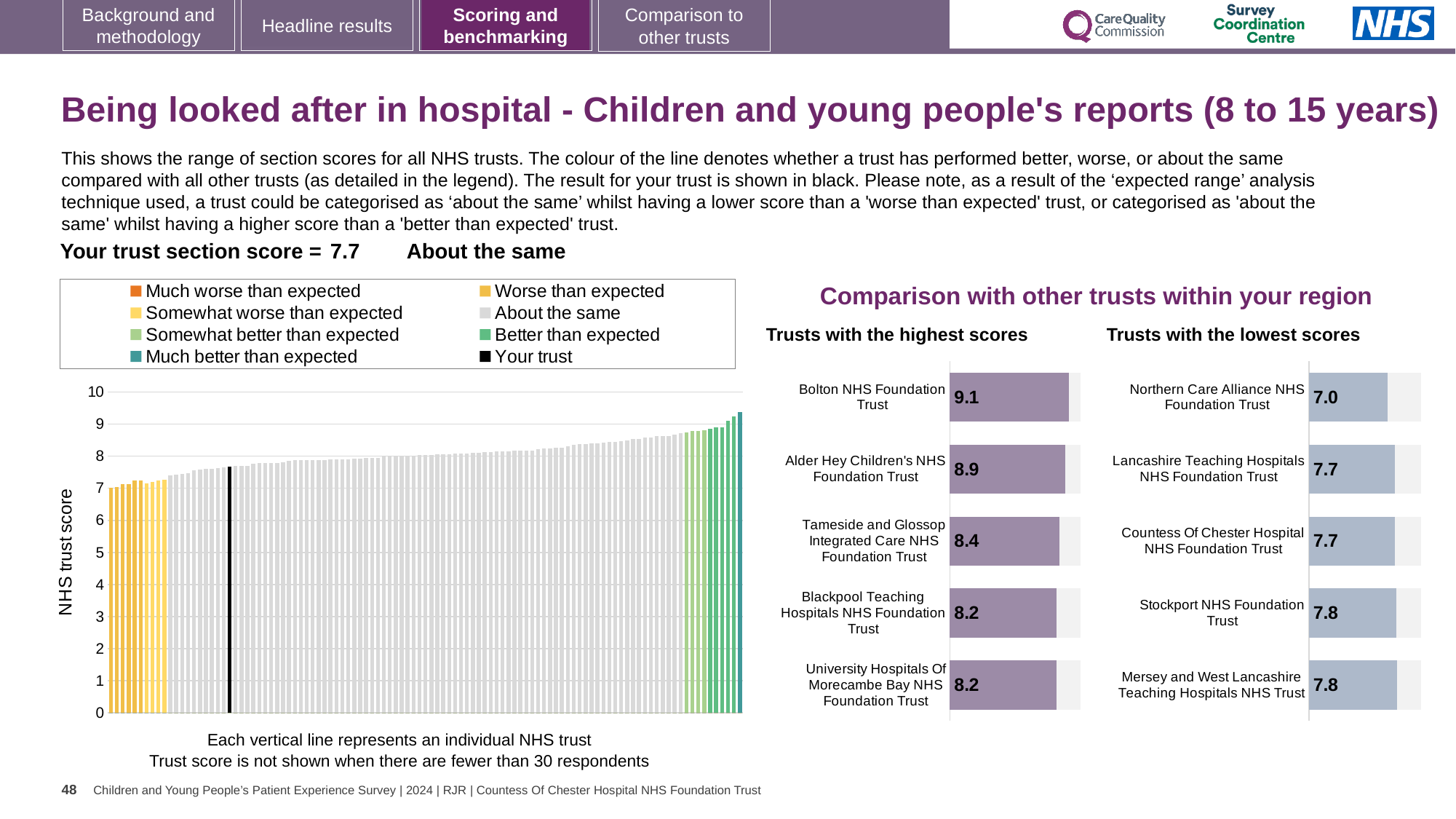
In the large chart on the left, is the value for the black 'Your trust' bar greater or less than 7? greater What kind of chart is the large chart on the left showing NHS trust scores? bar chart How many entries does the legend above the large chart on the left list? 8 In the 'Trusts with the highest scores' chart, which trust has the highest score? Bolton NHS Foundation Trust In the 'Trusts with the lowest scores' chart, what is the value for Northern Care Alliance NHS Foundation Trust? 7.0 In the 'Trusts with the lowest scores' chart, which is larger: the value for Stockport NHS Foundation Trust or Northern Care Alliance NHS Foundation Trust? Stockport NHS Foundation Trust How many trusts are shown in the 'Trusts with the highest scores' chart? 5 In the 'Trusts with the lowest scores' chart, which trust has the lowest score? Northern Care Alliance NHS Foundation Trust In the large chart on the left, do the trust scores rise or fall from left to right? rise In the 'Trusts with the highest scores' chart, what is the difference between Bolton NHS Foundation Trust and Tameside and Glossop Integrated Care NHS Foundation Trust? 0.7 In the large chart on the left, what is the highest value shown on the NHS trust score axis? 10 In the 'Trusts with the highest scores' chart, what is the value for Bolton NHS Foundation Trust? 9.1